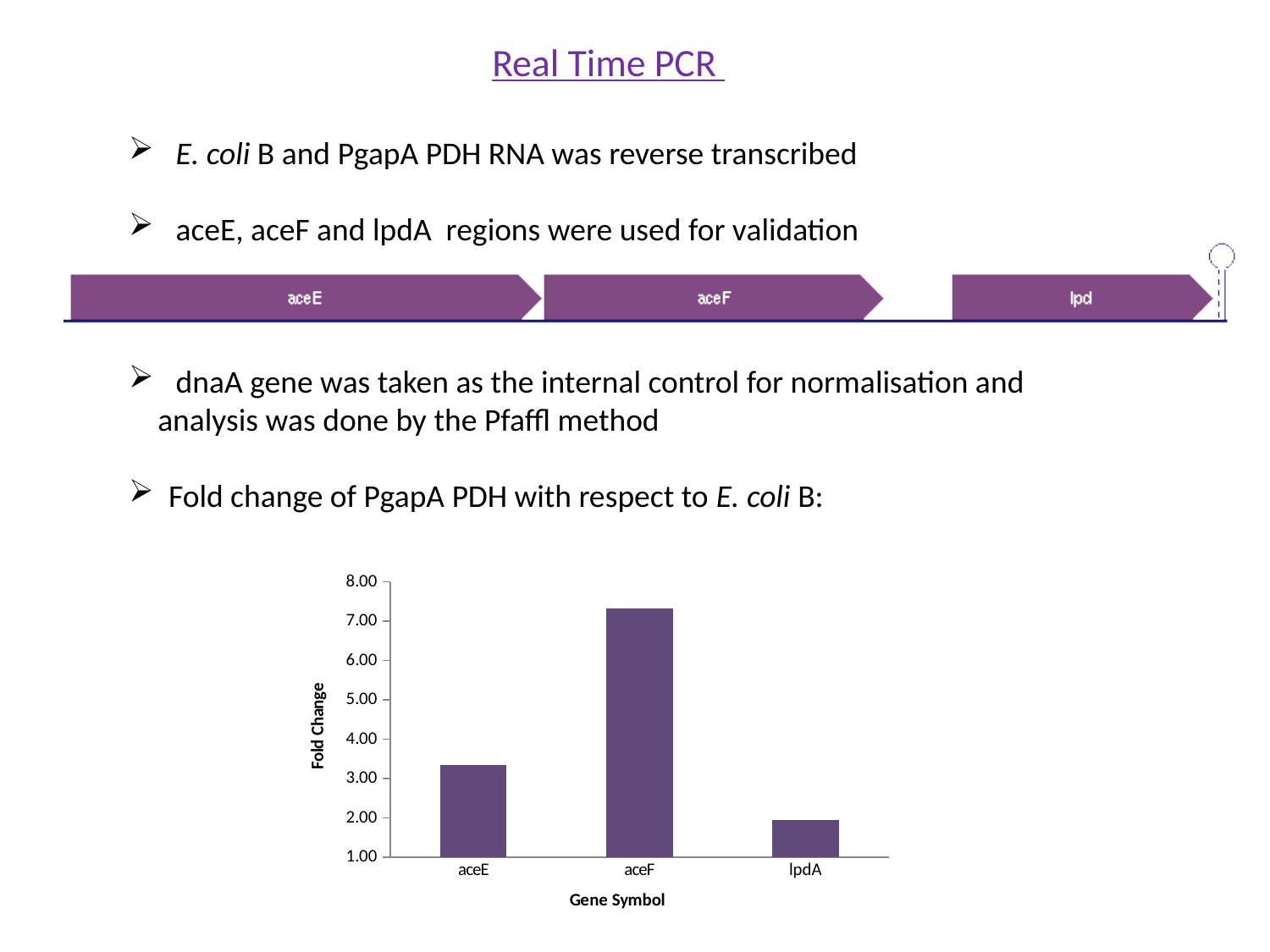
What is the title of the y axis of the chart? Fold Change Is the fold change for aceE greater or less than 4.00? less Which gene symbol has the highest fold change in the chart? aceF Which has a larger fold change, aceE or lpdA? aceE How many gene symbols are plotted on the x axis of the chart? 3 Is the fold change for aceF greater or less than 7.00? greater Is the fold change for aceE greater or less than 3.00? greater What kind of chart is shown on the slide? bar chart Which gene symbol has the lowest fold change in the chart? lpdA What is the title of the x axis of the chart? Gene Symbol Which has a larger fold change, aceF or aceE? aceF